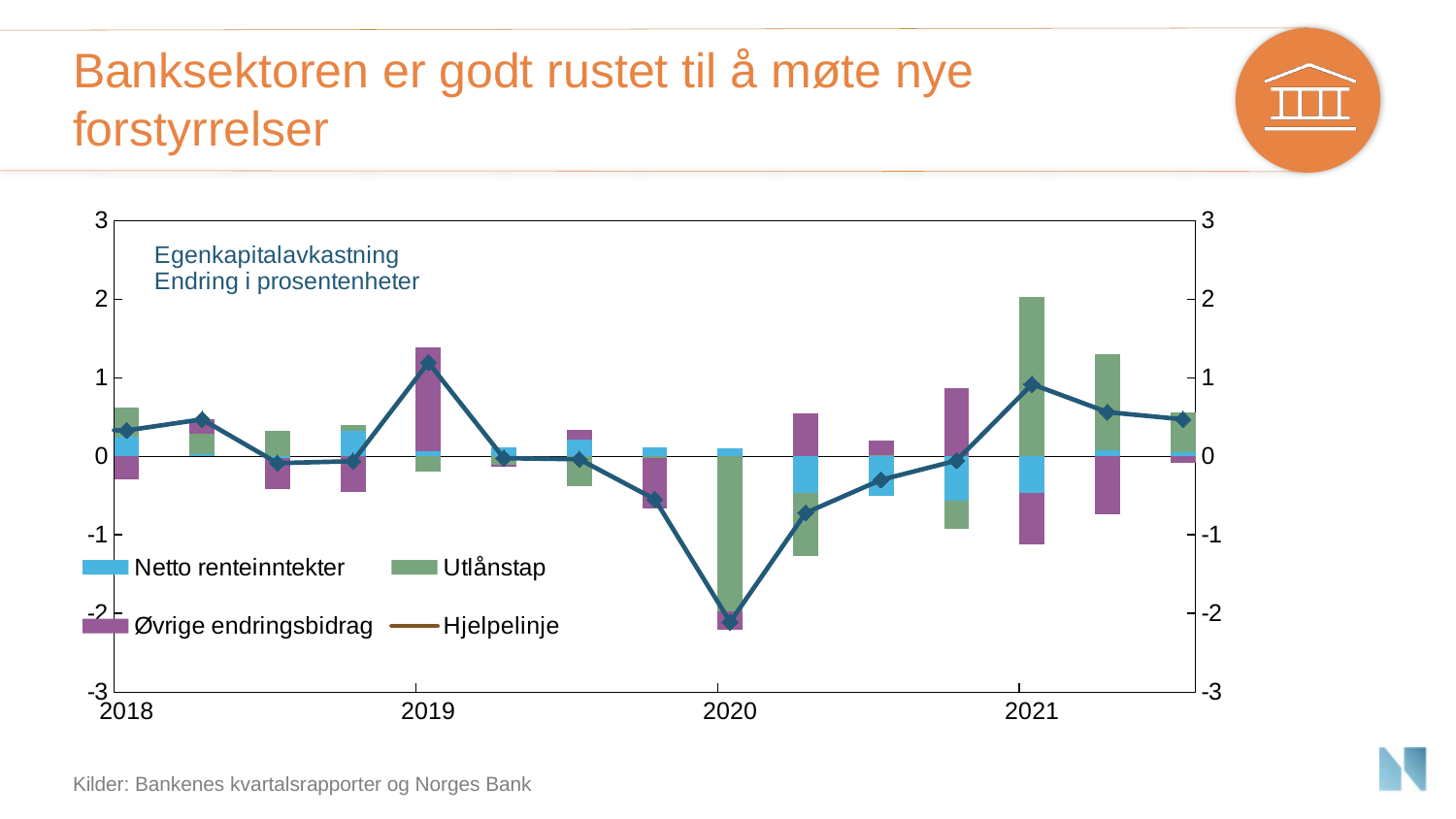
Is the top of the purple Øvrige endringsbidrag bar at 2019 greater or less than 1? greater What kind of chart is shown on the slide? Stacked bar chart with a line Which legend entry is shown in green? Utlånstap Is the top of the green Utlånstap bar at 2021 greater or less than 1? greater Is the bottom of the green Utlånstap bar at 2020 greater or less than -1? less How many quarterly bars are plotted in the chart? 15 How many series does the legend list? 4 At which point on the x axis does the Hjelpelinje line reach its lowest value? 2020 Does the Hjelpelinje line rise or fall between 2019 and 2020? fall What is the title of the chart? Egenkapitalavkastning Does the Hjelpelinje line rise or fall between 2020 and 2021? rise